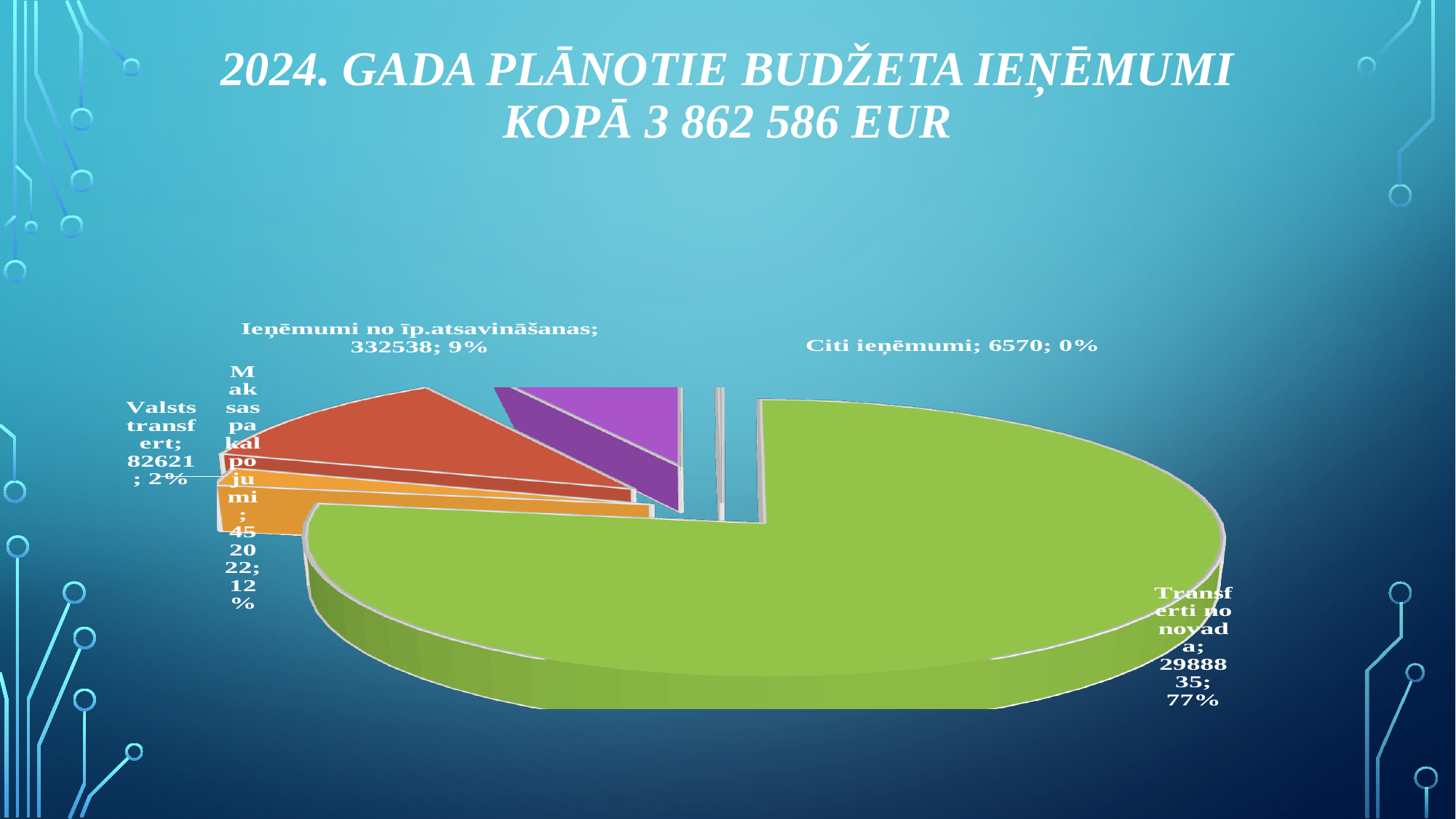
Which category has the largest slice? Transferti no novada What is the difference between the values for Maksas pakalpojumi and Ieņēmumi no īp.atsavināšanas? 119484 What percentage share does Ieņēmumi no īp.atsavināšanas have? 9% What is the value shown for Transferti no novada? 2988835 What is the value shown for Maksas pakalpojumi? 452022 Which is larger, Valsts transferti or Maksas pakalpojumi? Maksas pakalpojumi Which category has the smallest slice? Citi ieņēmumi What is the value shown for Citi ieņēmumi? 6570 What percentage share does Transferti no novada have? 77% What kind of chart is shown on the slide? pie chart How many slices does the pie chart have? 5 What total amount in EUR is stated in the slide title? 3 862 586 EUR